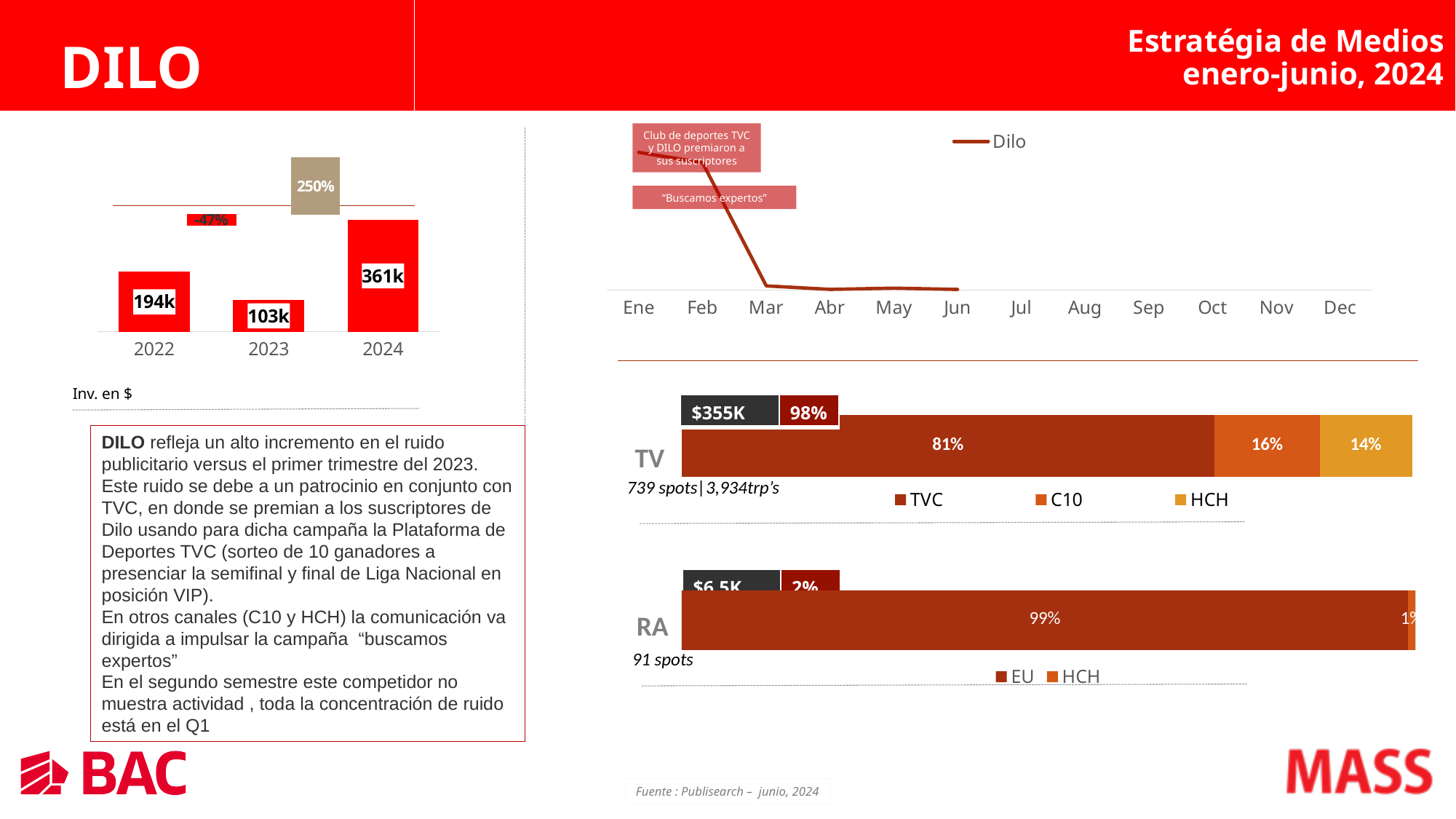
In the 'Inv. en $' bar chart, what is the value for 2024? 361k How many years are shown in the 'Inv. en $' bar chart? 3 In the 'Inv. en $' bar chart, which is larger, the value for 2022 or for 2023? 2022 In the 'Inv. en $' bar chart, what is the value for 2023? 103k In the RA stacked bar chart, what percentage is shown for EU? 99% In the 'Inv. en $' bar chart, which year has the highest value? 2024 In the 'Inv. en $' bar chart, which year has the lowest value? 2023 What kind of chart is the 'Inv. en $' chart on the left? bar chart In the 'Dilo' line chart, does the line rise or fall from Feb to Mar? fall How many series does the legend of the TV stacked bar chart list? 3 In the 'Inv. en $' bar chart, what is the difference between the 2024 and 2022 values? 167k In the TV stacked bar chart, what percentage is shown for TVC? 81%